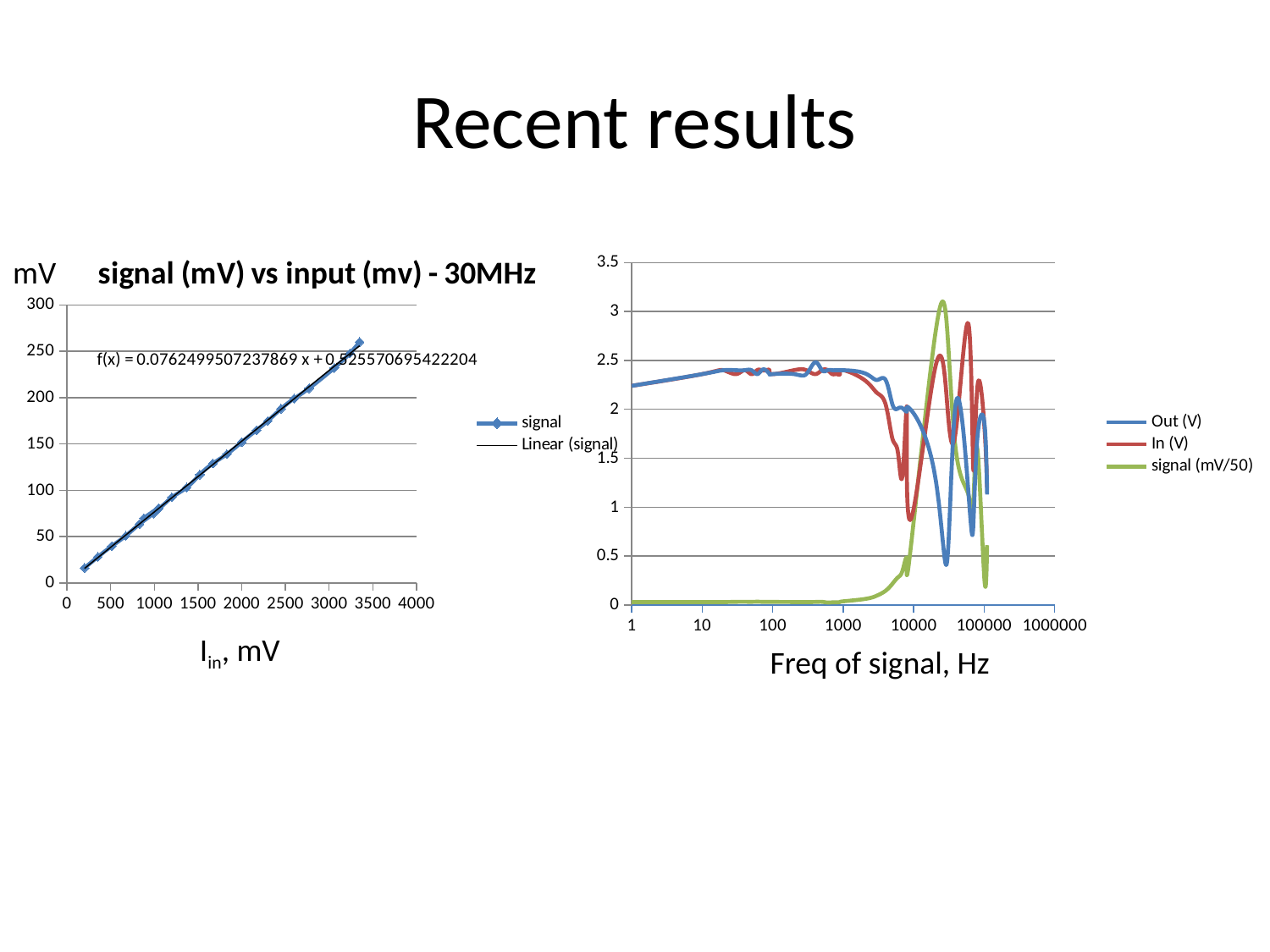
In the left chart 'signal (mV) vs input (mv) - 30MHz', is the signal value at an input of 500 mV greater or less than 100? less In the left chart 'signal (mV) vs input (mv) - 30MHz', is the signal value at an input of 3000 mV greater or less than 200? greater In the left chart 'signal (mV) vs input (mv) - 30MHz', do the signal values rise or fall as the input increases along the x axis? rise What are the legend entries of the right chart (Freq of signal, Hz)? Out (V), In (V), signal (mV/50) What kind of chart is the right chart with the x axis 'Freq of signal, Hz'? line chart In the right chart (Freq of signal, Hz), what is the highest value shown on the y axis? 3.5 In the right chart (Freq of signal, Hz), is the value of Out (V) at 10 Hz greater or less than 2? greater What kind of chart is the left chart titled 'signal (mV) vs input (mv) - 30MHz'? scatter chart with a linear trendline How many series does the legend of the right chart (Freq of signal, Hz) list? 3 What is the trendline equation shown on the left chart 'signal (mV) vs input (mv) - 30MHz'? f(x) = 0.0762499507237869 x + 0.525570695422204 In the right chart (Freq of signal, Hz), which series reaches the highest peak value? signal (mV/50)